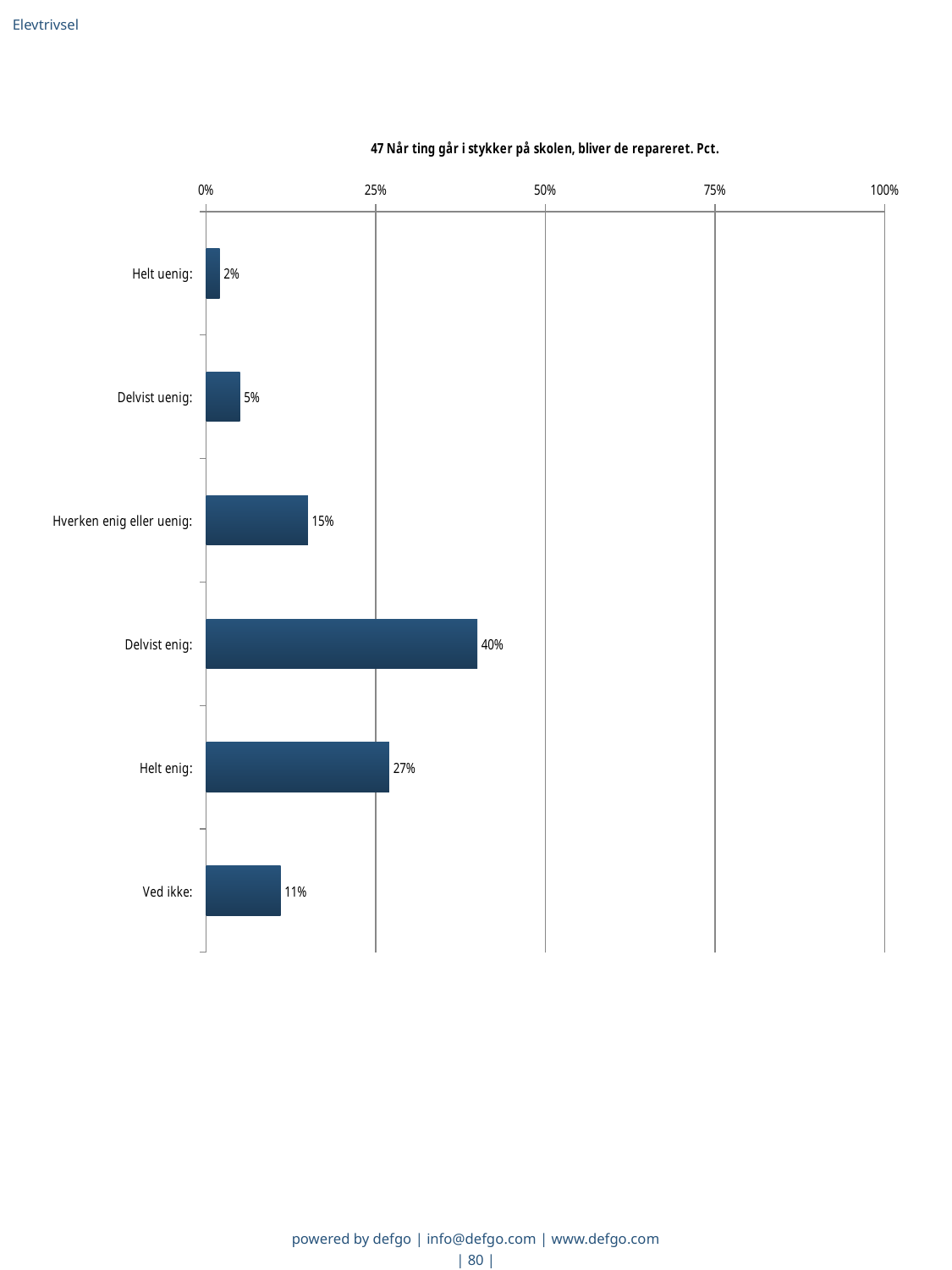
Which category has the highest value? Delvist enig What is the title of the chart? 47 Når ting går i stykker på skolen, bliver de repareret. Pct. What kind of chart is shown on the slide? Bar chart What is the value for Hverken enig eller uenig? 15% Is the value for Delvist enig greater or less than 25%? greater What is the value for Helt uenig? 2% What is the value for Ved ikke? 11% What is the value for Delvist enig? 40% What is the difference between the values for Delvist enig and Helt enig? 13% How many categories are shown in the chart? 6 Which is larger, the value for Helt enig or the value for Hverken enig eller uenig? Helt enig Which category has the lowest value? Helt uenig